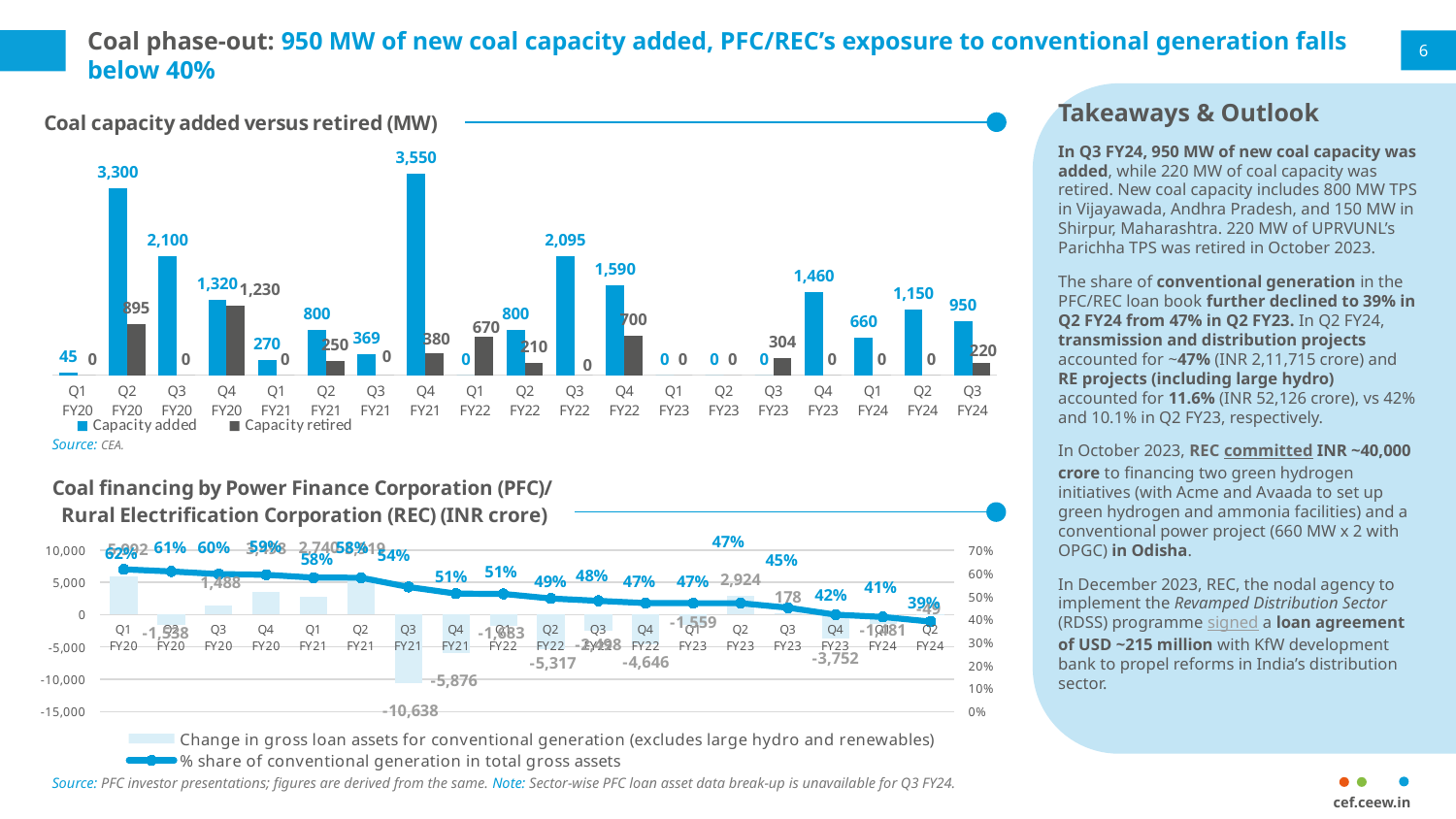
In the 'Coal financing by Power Finance Corporation (PFC)/Rural Electrification Corporation (REC) (INR crore)' chart, what is the change in gross loan assets for conventional generation in Q3 FY21? -10,638 In the 'Coal financing by Power Finance Corporation (PFC)/Rural Electrification Corporation (REC) (INR crore)' chart, what is the % share of conventional generation in total gross assets in Q2 FY24? 39% How many series does the legend of the 'Coal capacity added versus retired (MW)' chart list? 2 In the 'Coal capacity added versus retired (MW)' chart, what is the capacity retired in Q4 FY20? 1,230 In the 'Coal capacity added versus retired (MW)' chart, what is the difference between capacity added and capacity retired in Q2 FY20? 2,405 In the 'Coal capacity added versus retired (MW)' chart, which quarter has the highest capacity added? Q4 FY21 What kind of chart is the 'Coal capacity added versus retired (MW)' chart? Bar chart In the 'Coal financing by Power Finance Corporation (PFC)/Rural Electrification Corporation (REC) (INR crore)' chart, what colour is the line for % share of conventional generation in total gross assets? Blue In the 'Coal capacity added versus retired (MW)' chart, which is larger in Q1 FY22: capacity added or capacity retired? Capacity retired How many quarters are shown on the x axis of the 'Coal capacity added versus retired (MW)' chart? 19 In the 'Coal financing by Power Finance Corporation (PFC)/Rural Electrification Corporation (REC) (INR crore)' chart, does the % share of conventional generation in total gross assets rise or fall from Q1 FY20 to Q2 FY24? Fall In the 'Coal capacity added versus retired (MW)' chart, what is the capacity added in Q3 FY24? 950